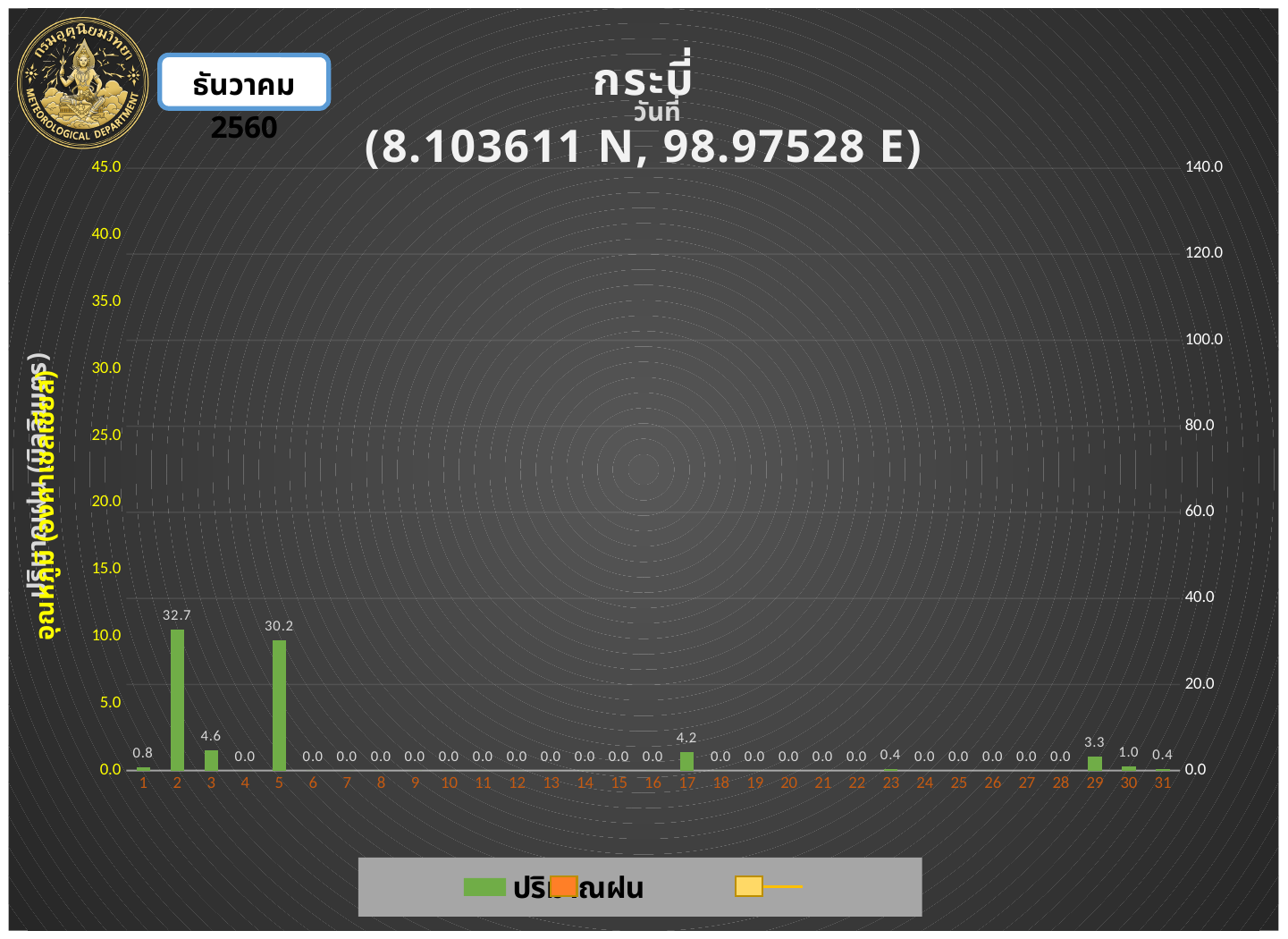
What is the combined value for days 29, 30 and 31? 4.7 Which day has the highest rainfall value? 2 What is the rainfall value shown for day 5? 30.2 What is the value labelled for day 17? 4.2 What coordinates are given in the chart title? 8.103611 N, 98.97528 E Which has the larger value, day 3 or day 17? day 3 How many days are shown on the x axis? 31 What is the value labelled for day 29? 3.3 What is the difference between the values for day 2 and day 5? 2.5 What is the rainfall value shown for day 2? 32.7 What kind of chart is this? bar chart What colour are the rainfall bars? green